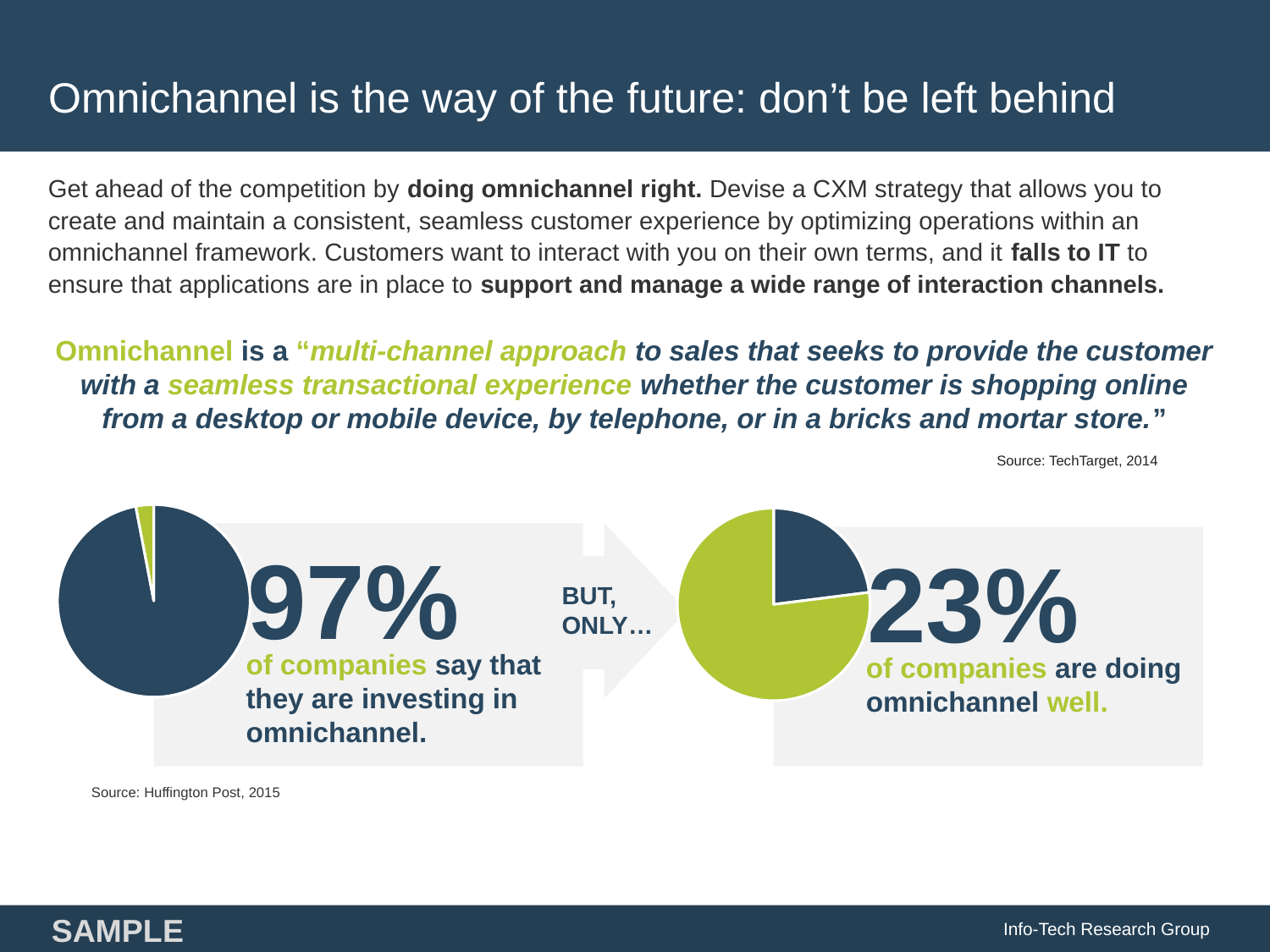
How many slices does the right pie chart have? 2 In the right pie chart, what percentage of companies are doing omnichannel well? 23% In the right pie chart, is the green slice greater or less than 50% of the pie? greater What source is cited for the two pie charts? Huffington Post, 2015 In the left pie chart, what percentage of companies say they are investing in omnichannel? 97% What colour is the 23% slice in the right pie chart? Dark blue Which is larger: the share of companies investing in omnichannel (left chart) or the share doing omnichannel well (right chart)? The share investing in omnichannel (97%) What is the difference between the percentage of companies investing in omnichannel (left chart) and the percentage doing omnichannel well (right chart)? 74 percentage points In the left pie chart, is the green slice greater or less than 10% of the pie? less How many slices does the left pie chart have? 2 What kind of chart is used on the left to show the share of companies investing in omnichannel? Pie chart